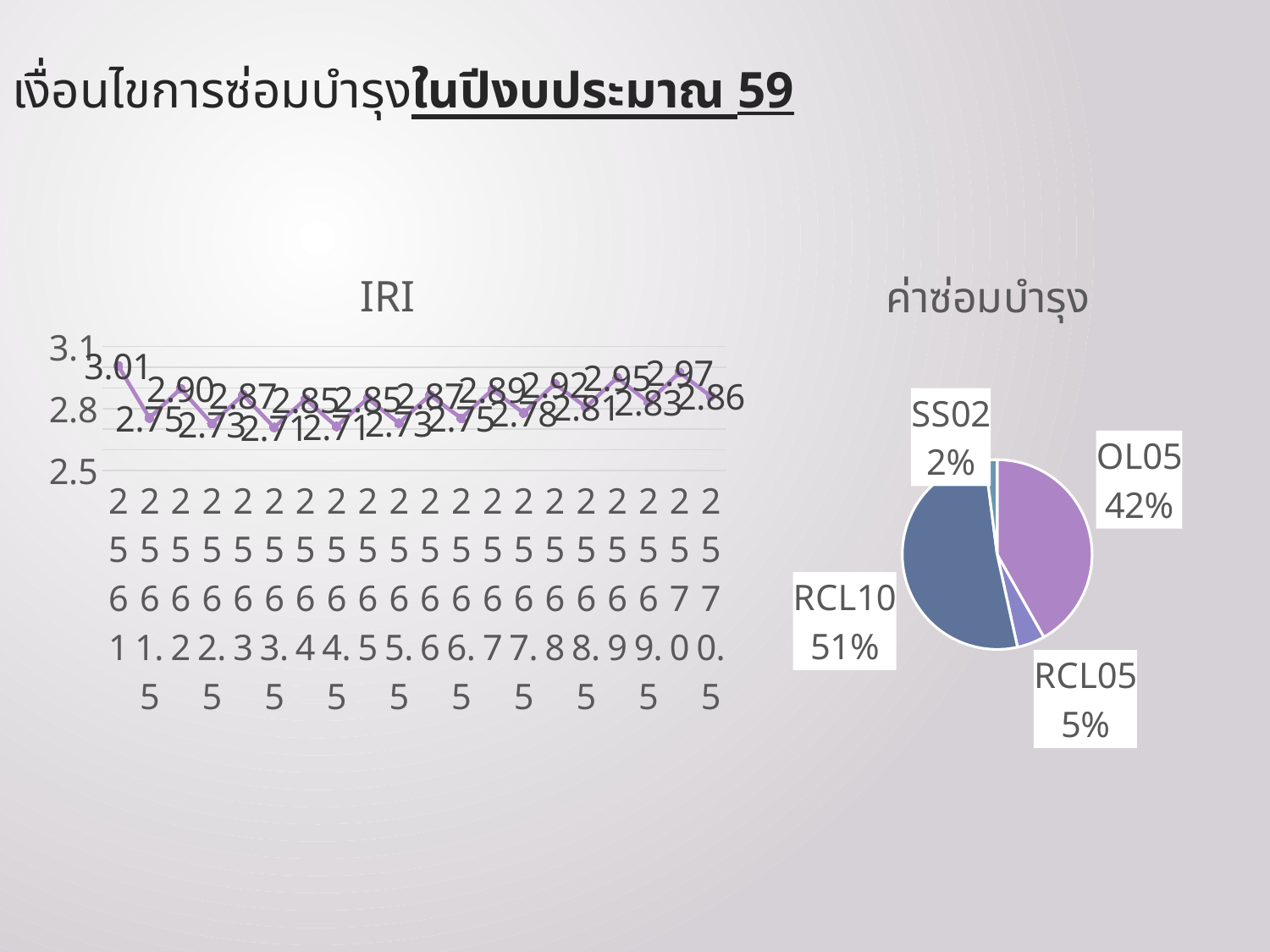
What kind of chart is the chart titled "ค่าซ่อมบำรุง"? pie chart In the "IRI" chart, how many data points are plotted? 20 In the "IRI" chart, what is the value of the last data point on the right? 2.86 In the "ค่าซ่อมบำรุง" pie chart, which slice is the smallest? SS02 In the "IRI" chart, is the value of the first data point greater or less than 2.8? greater In the "ค่าซ่อมบำรุง" pie chart, how many slices are there? 4 In the "IRI" chart, what is the value of the first data point on the left? 3.01 In the "IRI" chart, what is the highest value plotted? 3.01 In the "ค่าซ่อมบำรุง" pie chart, what share does RCL10 have? 51% What kind of chart is the chart titled "IRI"? line chart In the "ค่าซ่อมบำรุง" pie chart, what share does OL05 have? 42% In the "ค่าซ่อมบำรุง" pie chart, what is the difference between the shares of RCL10 and OL05? 9%